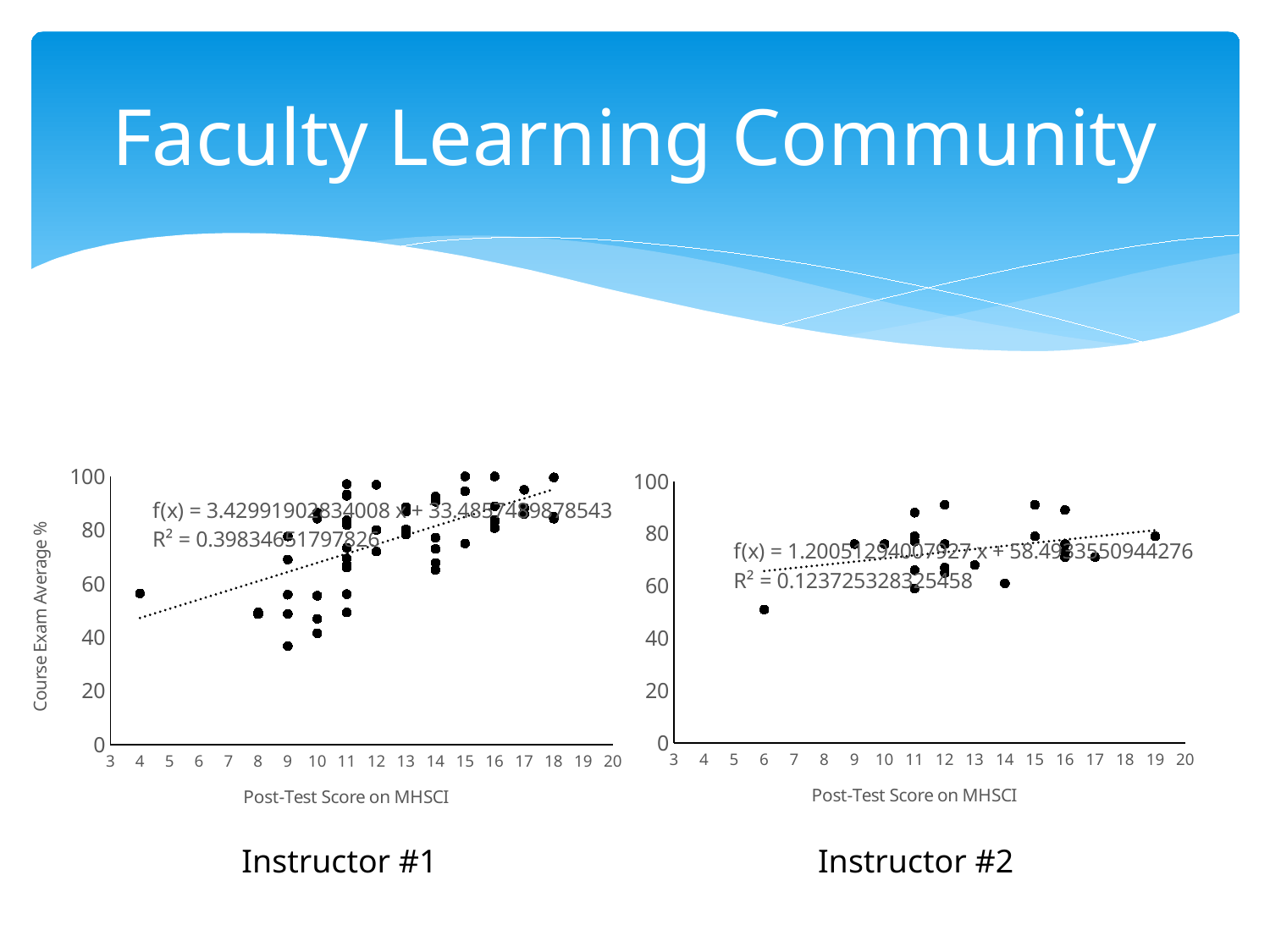
What kind of chart is the Instructor #2 chart? scatter plot In the Instructor #2 chart, is the course exam average for the point at post-test score 6 greater or less than 60? less In the Instructor #2 chart, does the trend line rise or fall as the post-test score increases? rises What kind of chart is the Instructor #1 chart? scatter plot Which chart shows the higher R² value, Instructor #1 or Instructor #2? Instructor #1 In the Instructor #1 chart, is the course exam average for the point at post-test score 4 greater or less than 40? greater In the Instructor #1 chart, does the trend line rise or fall as the post-test score increases? rises What is the x-axis label on the Instructor #2 chart? Post-Test Score on MHSCI In the Instructor #1 chart, is the lowest point at post-test score 9 greater or less than 60? less What is the y-axis label on the Instructor #1 chart? Course Exam Average %